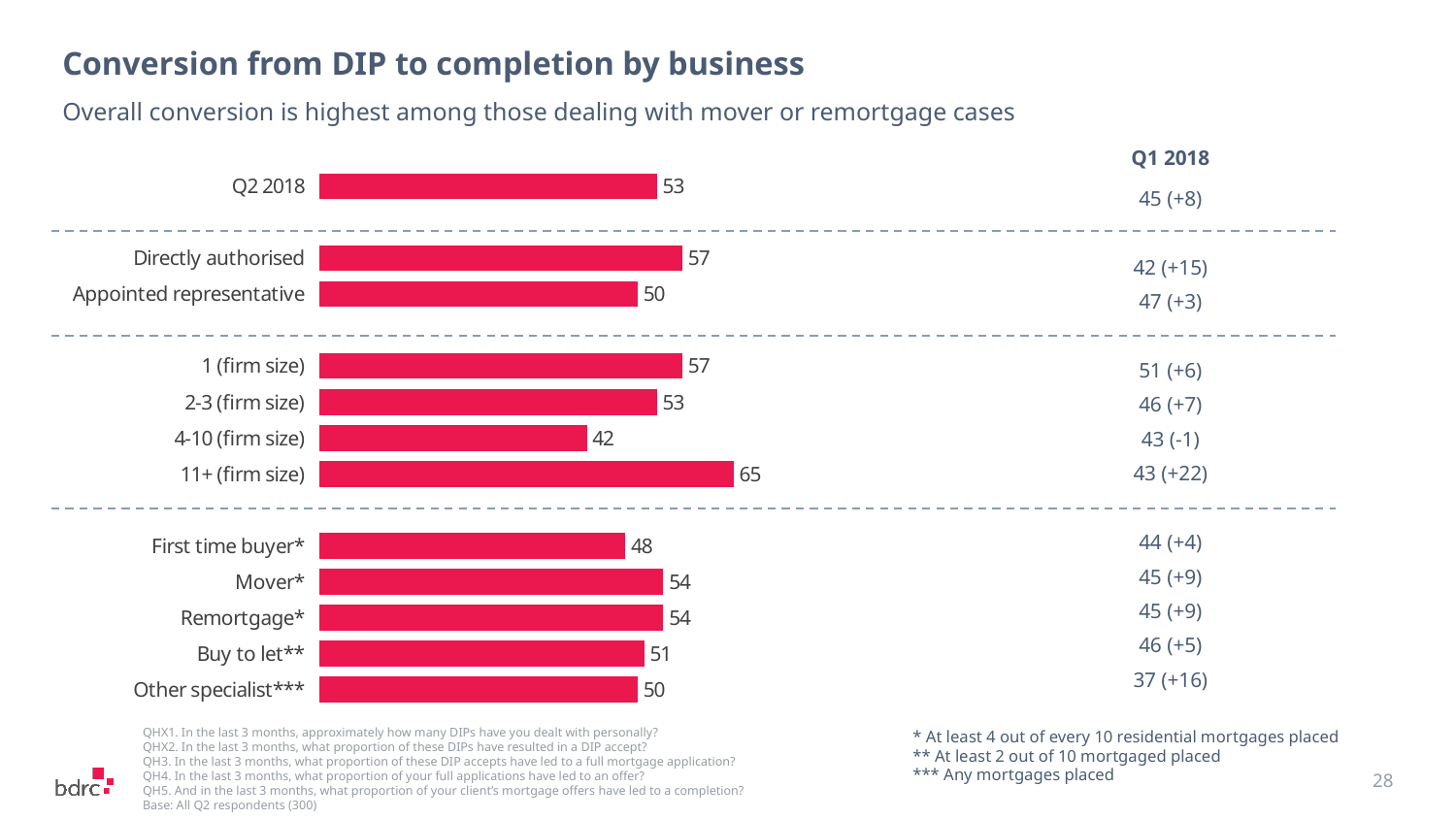
How many bars are plotted in the chart? 12 What is the difference between the values for 11+ (firm size) and 4-10 (firm size)? 23 Which category has the lowest value? 4-10 (firm size) What is the value for 11+ (firm size)? 65 Which is larger, the value for Mover* or the value for Buy to let**? Mover* What is the value for Appointed representative? 50 What kind of chart is shown on the slide? Bar chart What is the value for First time buyer*? 48 What is the title of the slide's chart? Conversion from DIP to completion by business What is the value for Q2 2018 overall? 53 Which category has the highest value? 11+ (firm size) What is the difference between the values for Directly authorised and Appointed representative? 7